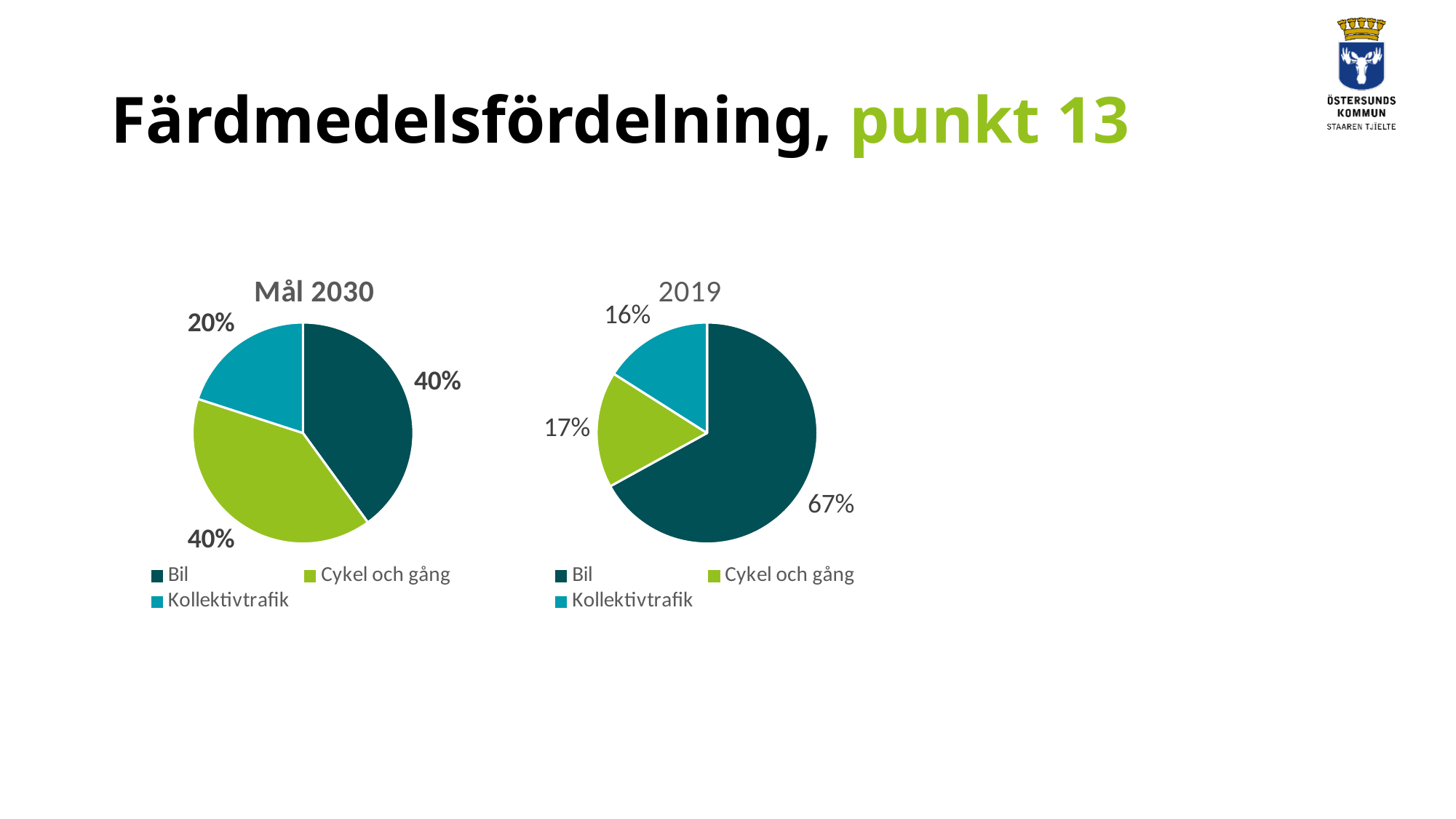
In the 'Mål 2030' pie chart, what share does Kollektivtrafik have? 20% In the '2019' pie chart, what share does Bil have? 67% In the '2019' pie chart, what share does Cykel och gång have? 17% How many entries does the legend of the 'Mål 2030' chart list? 3 In the '2019' pie chart, what share does Kollektivtrafik have? 16% Which is larger in the '2019' pie chart: the Bil slice or the Kollektivtrafik slice? Bil In the '2019' pie chart, which category has the largest slice? Bil In the 'Mål 2030' pie chart, which category has the smallest slice? Kollektivtrafik In the '2019' pie chart, what is the difference between the Bil share and the Cykel och gång share? 50% In the 'Mål 2030' pie chart, what share does Bil have? 40% What type of chart is the '2019' chart? Pie chart How many slices does the 'Mål 2030' pie chart have? 3